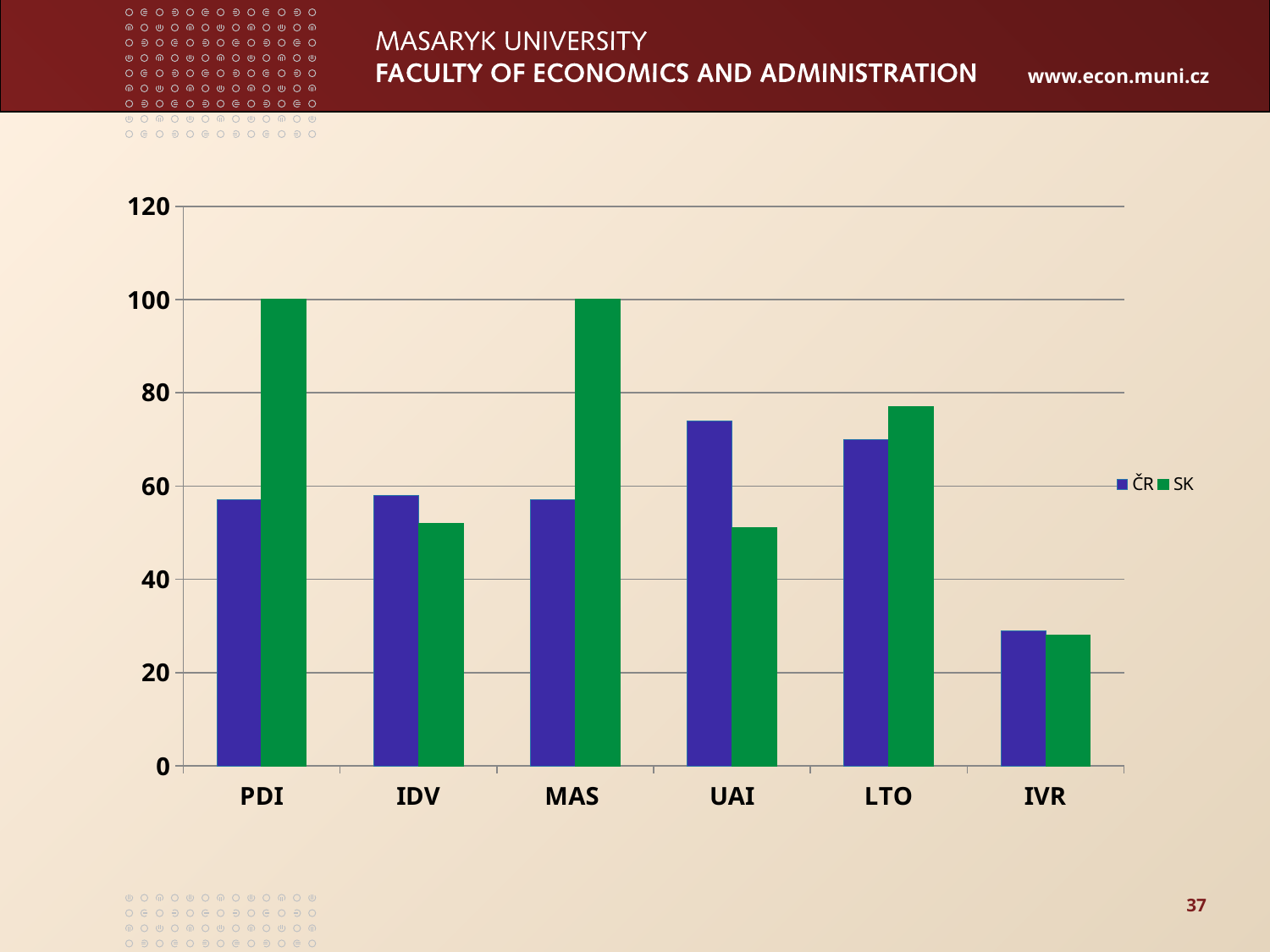
Is the ČR value for PDI greater or less than 60? less Which category has the lowest ČR value? IVR Is the ČR value for UAI greater or less than 60? greater What is the SK value for PDI? 100 What kind of chart is shown on the slide? bar chart For UAI, which series has the larger value, ČR or SK? ČR Which series is shown in green in the chart? SK What is the SK value for MAS? 100 Is the SK value for UAI greater or less than 60? less How many series does the chart's legend list? 2 How many categories are shown on the x axis of the chart? 6